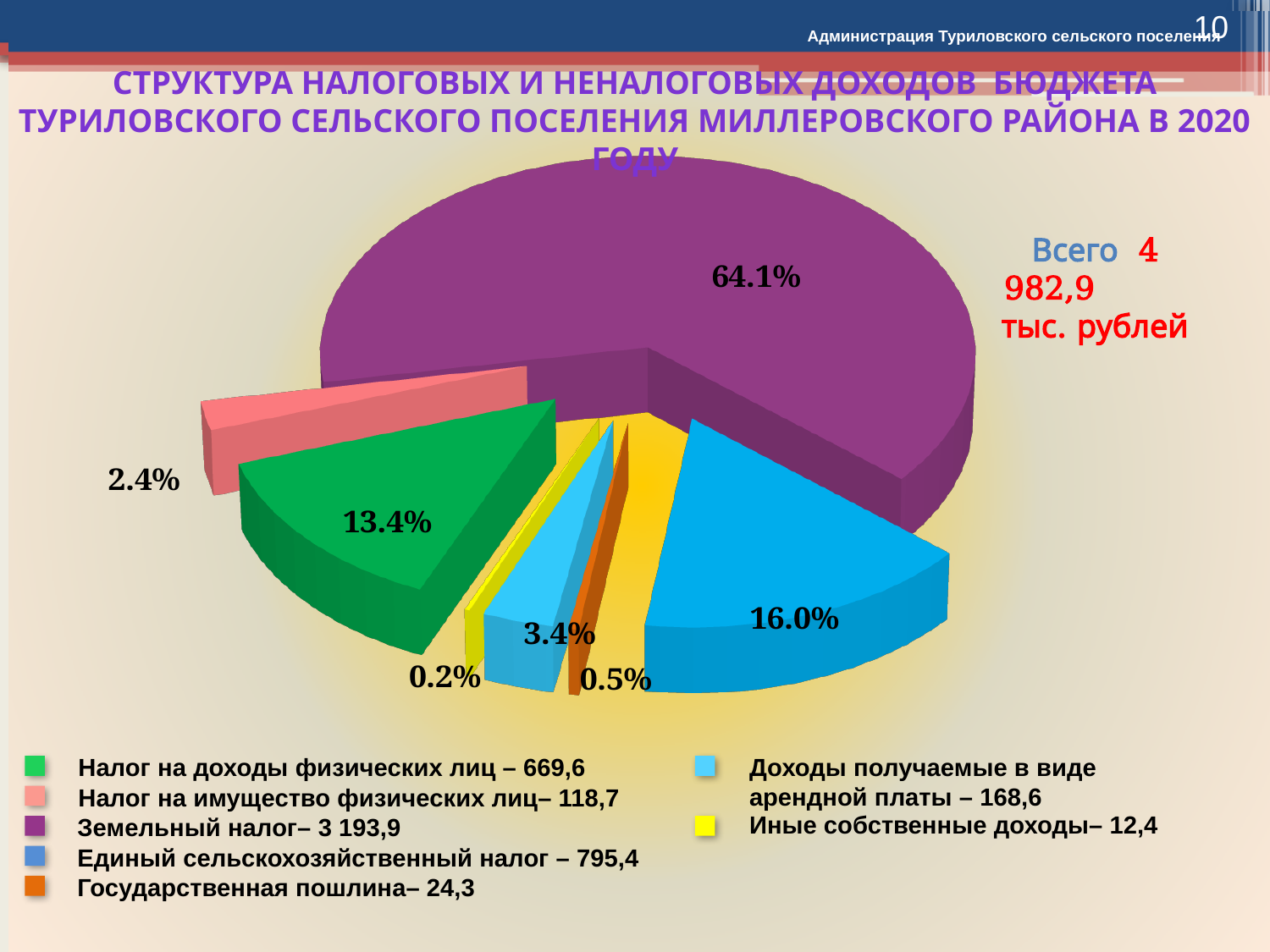
What value does the legend give for Земельный налог? 3 193,9 What share of the pie does Налог на доходы физических лиц (the green slice) take? 13.4% Which category has the smallest slice of the pie? Иные собственные доходы Which category has the largest slice of the pie? Земельный налог How many slices does the pie chart have? 7 What share of the pie does Земельный налог (the purple slice) take? 64.1% Which slice is larger: Налог на доходы физических лиц or Доходы получаемые в виде арендной платы? Налог на доходы физических лиц What share of the pie does Единый сельскохозяйственный налог (the blue slice) take? 16.0% What is the difference in percentage points between the Земельный налог slice (64.1%) and the Единый сельскохозяйственный налог slice (16.0%)? 48.1 What kind of chart is shown on the slide? pie chart What total (Всего) is stated next to the pie chart? 4 982,9 тыс. рублей